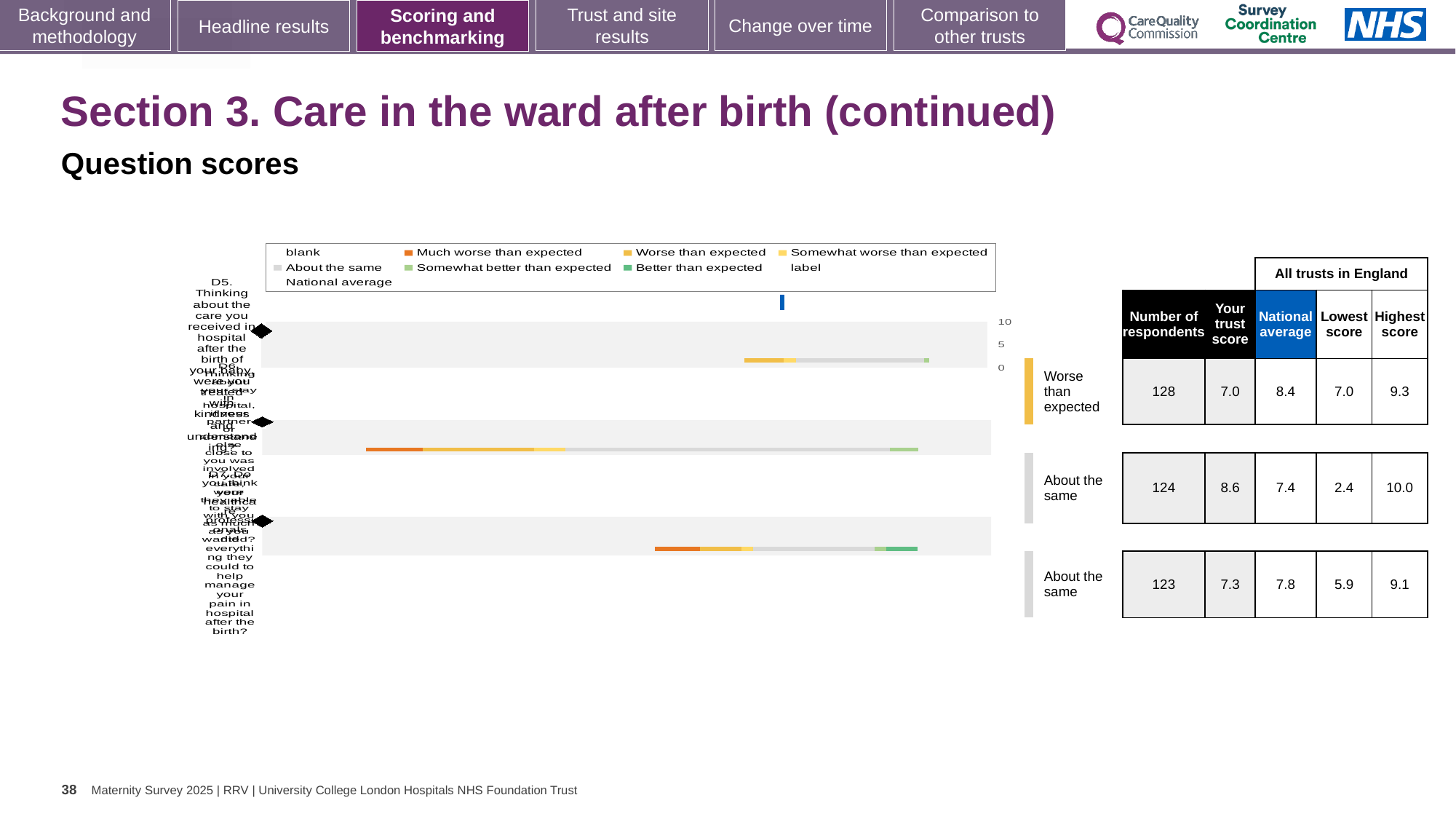
In the table beside the chart, what is the national average for the row with 124 respondents? 7.4 In the table beside the chart, which row has the highest 'Highest score' value? the row with 124 respondents (10.0) What kind of chart is shown on the slide? bar chart In the table beside the chart, for the row with 124 respondents, which is larger: the trust score or the national average? the trust score In the table beside the chart, what is the smallest 'Lowest score' value shown? 2.4 How many entries does the chart legend list? 9 What colour does the legend use for 'Much worse than expected'? orange In the table beside the chart, what is the difference between the national average (8.4) and the trust score (7.0) for the 'Worse than expected' row? 1.4 In the table beside the chart, what is 'Your trust score' for the row rated 'Worse than expected'? 7.0 What is the highest tick value shown on the chart's score axis? 10 How many question rows (bars) are plotted in the chart? 3